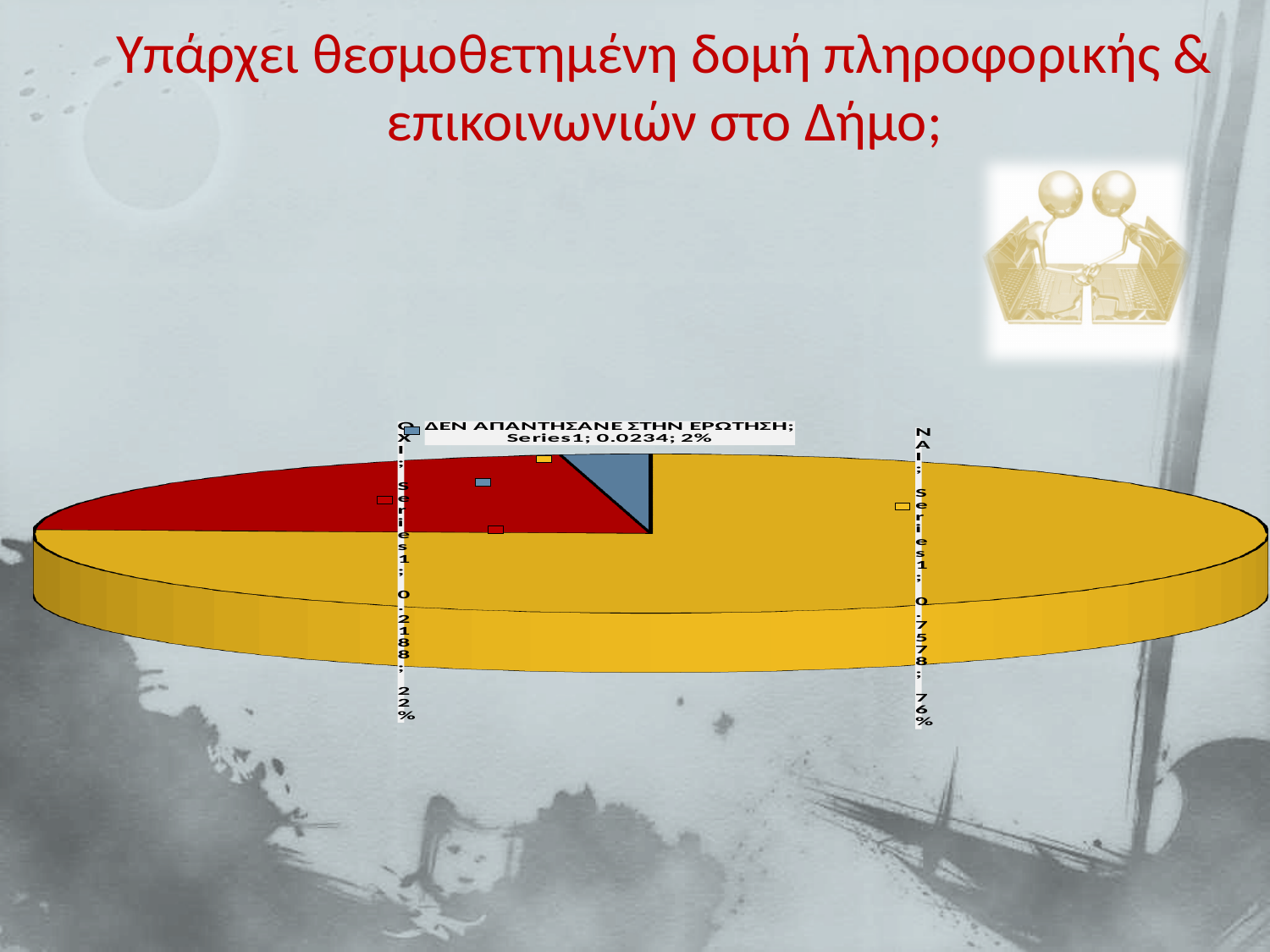
What percentage of the pie does the ΟΧΙ slice represent? 22% What is the value printed for the ΔΕΝ ΑΠΑΝΤΗΣΑΝΕ ΣΤΗΝ ΕΡΩΤΗΣΗ slice? 0.0234 Which slice of the pie is the smallest? ΔΕΝ ΑΠΑΝΤΗΣΑΝΕ ΣΤΗΝ ΕΡΩΤΗΣΗ What is the difference in percentage points between the ΝΑΙ slice and the ΟΧΙ slice? 54 percentage points Which slice of the pie is the largest? ΝΑΙ Which is larger, the ΟΧΙ slice or the ΝΑΙ slice? ΝΑΙ What percentage of the pie does the ΝΑΙ slice represent? 76% What is the value printed for the ΟΧΙ slice? 0.2188 How many slices does the pie chart have? 3 What kind of chart is shown on the slide? pie chart What is the value printed for the ΝΑΙ slice? 0.7578 What percentage of the pie does the ΔΕΝ ΑΠΑΝΤΗΣΑΝΕ ΣΤΗΝ ΕΡΩΤΗΣΗ slice represent? 2%